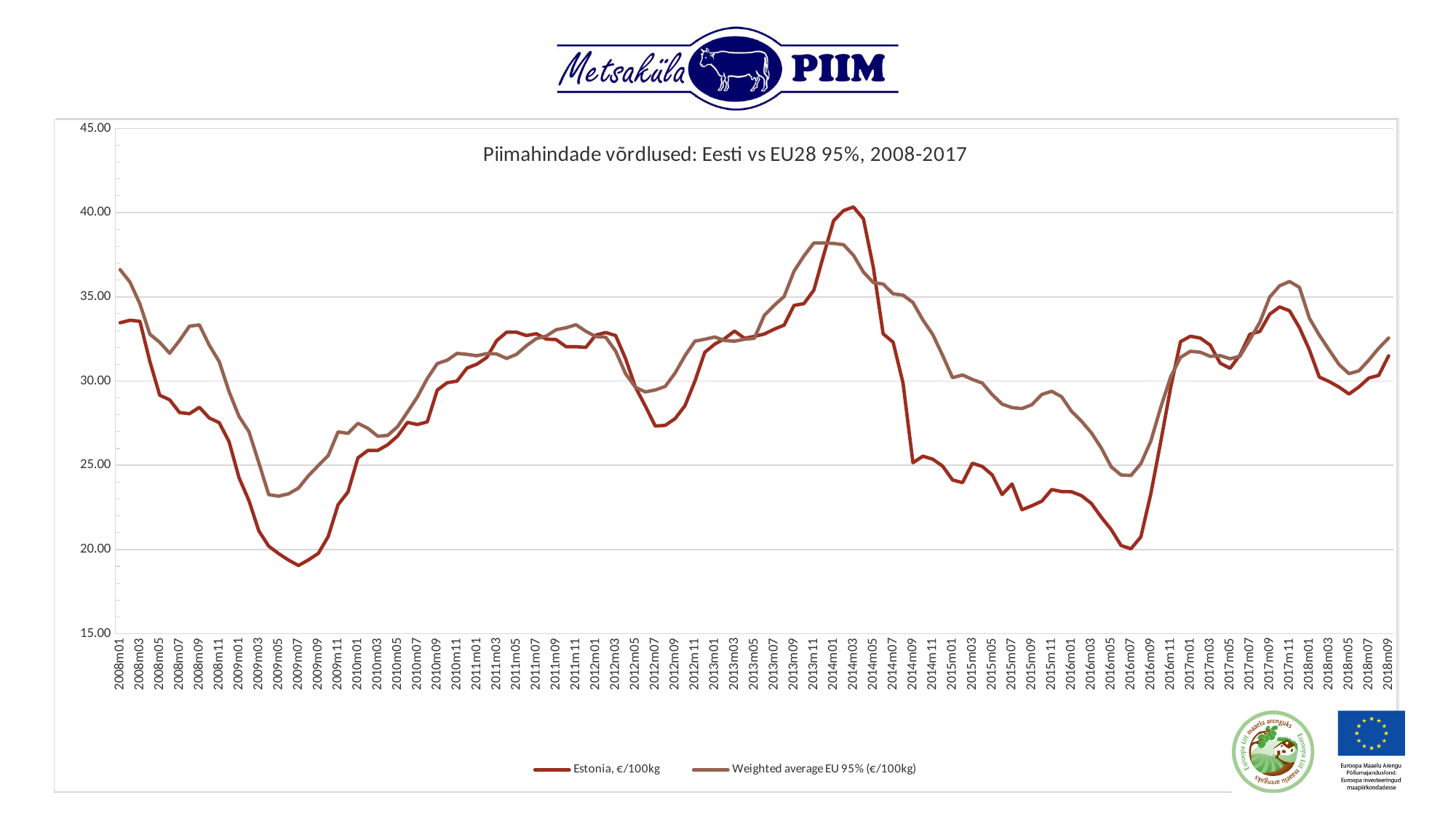
Which series is drawn as the lighter brown line? Weighted average EU 95% (€/100kg) Is the value for Estonia, €/100kg at 2012m07 greater or less than 30.00? less How many series does the legend list? 2 Does the Estonia, €/100kg series rise or fall between 2014m03 and 2016m07? fall Is the value for Estonia, €/100kg at 2014m03 greater or less than 35.00? greater At 2014m09, which series has the higher value: Estonia, €/100kg or Weighted average EU 95% (€/100kg)? Weighted average EU 95% (€/100kg) Is the value for Weighted average EU 95% (€/100kg) at 2017m11 greater or less than 35.00? greater What kind of chart is shown on the slide? line chart At 2014m03, which series has the higher value: Estonia, €/100kg or Weighted average EU 95% (€/100kg)? Estonia, €/100kg What is the title of the chart? Piimahindade võrdlused: Eesti vs EU28 95%, 2008-2017